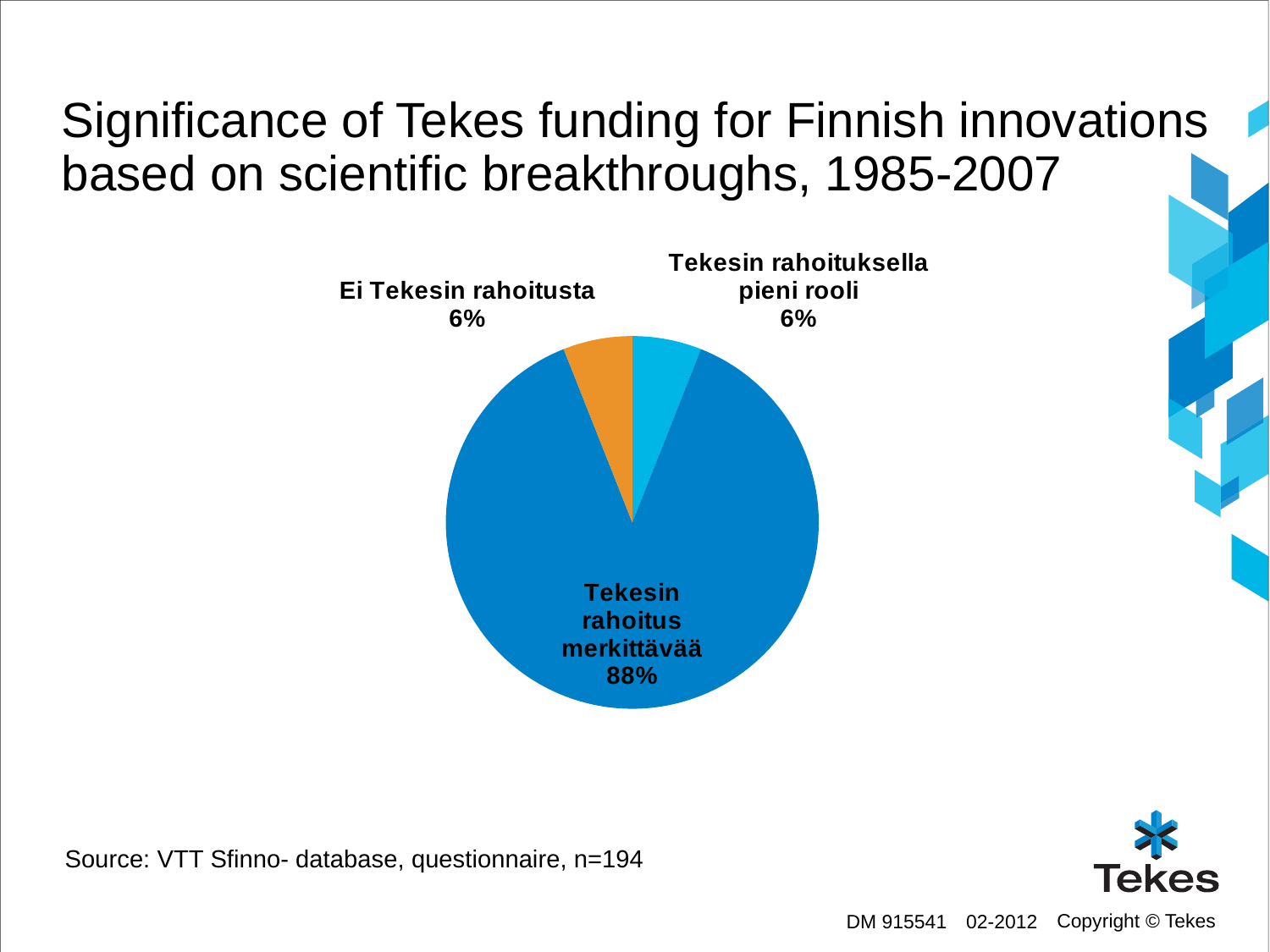
What type of chart is shown on the slide? Pie chart What is the value shown for "Tekesin rahoituksella pieni rooli"? 6% How many slices does the pie chart have? 3 What is the combined share of "Ei Tekesin rahoitusta" and "Tekesin rahoituksella pieni rooli"? 12% What share of the pie does "Tekesin rahoitus merkittävää" represent? 88% Which slice of the pie is the largest? Tekesin rahoitus merkittävää What is the sample size (n) given in the source note below the chart? n=194 What is the difference between the share for "Tekesin rahoitus merkittävää" and the share for "Ei Tekesin rahoitusta"? 82% Which is larger: the share for "Tekesin rahoitus merkittävää" or the share for "Tekesin rahoituksella pieni rooli"? Tekesin rahoitus merkittävää What is the value shown for "Ei Tekesin rahoitusta"? 6% What colour is the "Ei Tekesin rahoitusta" slice? Orange